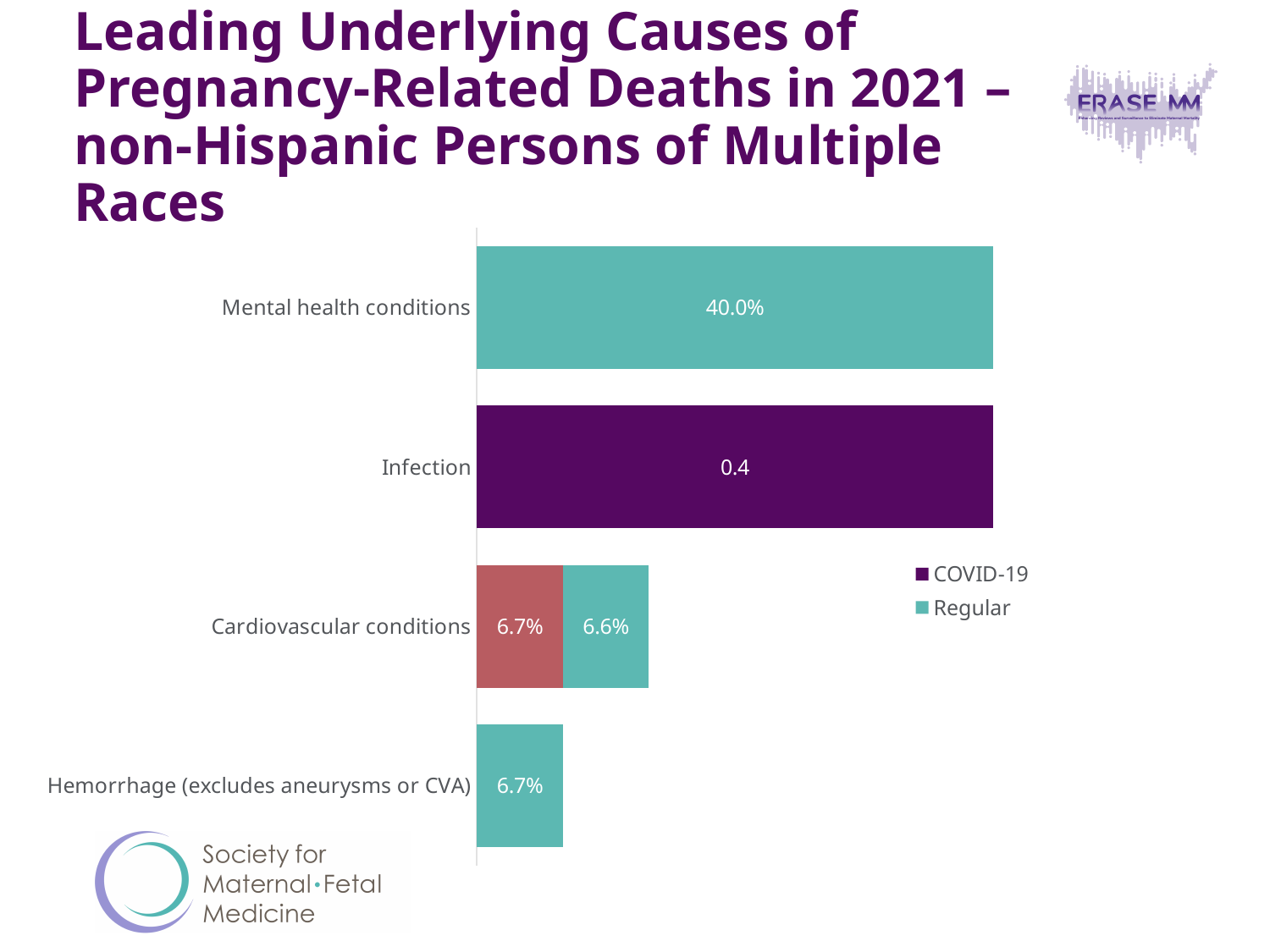
What is the value shown for Mental health conditions? 40.0% What kind of chart is shown on the slide? Bar chart Which category has the shortest bar? Hemorrhage (excludes aneurysms or CVA) What are the two entries in the chart legend? COVID-19 and Regular What is the difference between the Mental health conditions value and the Hemorrhage (excludes aneurysms or CVA) value? 33.3% Which is larger, the value for Mental health conditions or the value for Hemorrhage (excludes aneurysms or CVA)? Mental health conditions What is the value of the teal (Regular) segment of the Cardiovascular conditions bar? 6.6% How many categories are shown on the chart? 4 What data label is printed on the Infection bar? 0.4 What is the total of the two segments in the Cardiovascular conditions bar? 13.3% What is the value shown for Hemorrhage (excludes aneurysms or CVA)? 6.7% How many series does the legend list? 2